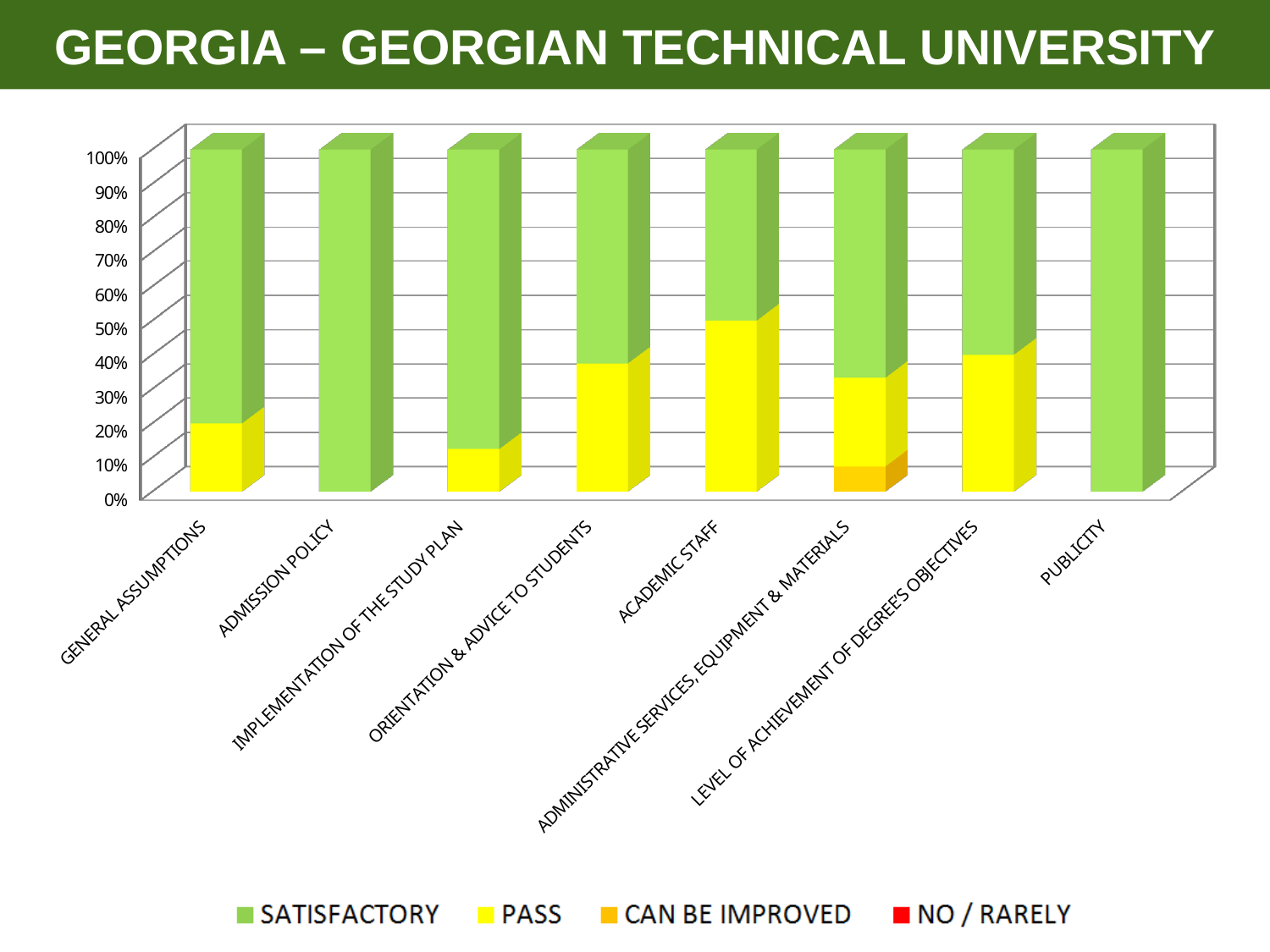
Is the PASS value for General Assumptions greater or less than 30%? less How many series does the chart's legend list? 4 Which colour represents the PASS series in the legend? Yellow Is the PASS value for Orientation & Advice to Students greater or less than 30%? greater Is the PASS value for Academic Staff greater or less than 40%? greater Which is larger, the PASS segment for Academic Staff or the PASS segment for General Assumptions? Academic Staff What kind of chart is shown on the slide? Stacked bar chart Which category has the largest PASS segment? Academic Staff How many categories are shown along the x axis of the chart? 8 Which category is the only one with a CAN BE IMPROVED segment? Administrative Services, Equipment & Materials